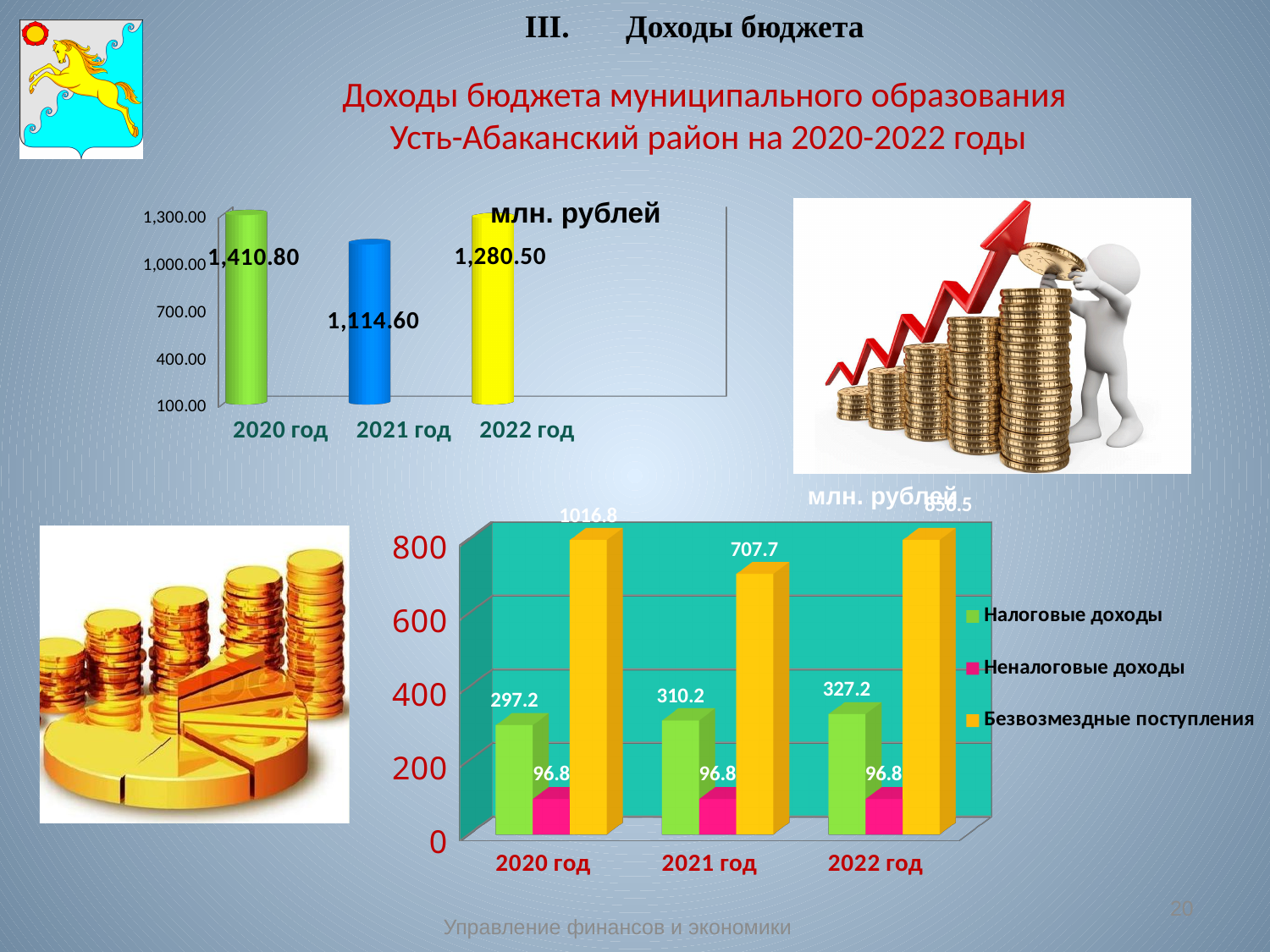
In the top-left chart, what is the value for 2020 год? 1,410.80 In the top-left chart, what is the difference between the values for 2020 год and 2021 год? 296.20 In the top-left chart, what is the value for 2022 год? 1,280.50 In the top-left chart, which year has the highest value? 2020 год In the top-left chart, what is the value for 2021 год? 1,114.60 In the bottom chart, what is the value of Налоговые доходы for 2022 год? 327.2 In the bottom chart, do the values of Налоговые доходы rise or fall from 2020 год to 2022 год? rise In the bottom chart, how many series does the legend list? 3 In the top-left chart, which year has the lowest value? 2021 год In the bottom chart, what is the value of Безвозмездные поступления for 2021 год? 707.7 In the top-left chart, how many years are shown? 3 In the bottom chart, what is the value of Неналоговые доходы for 2020 год? 96.8